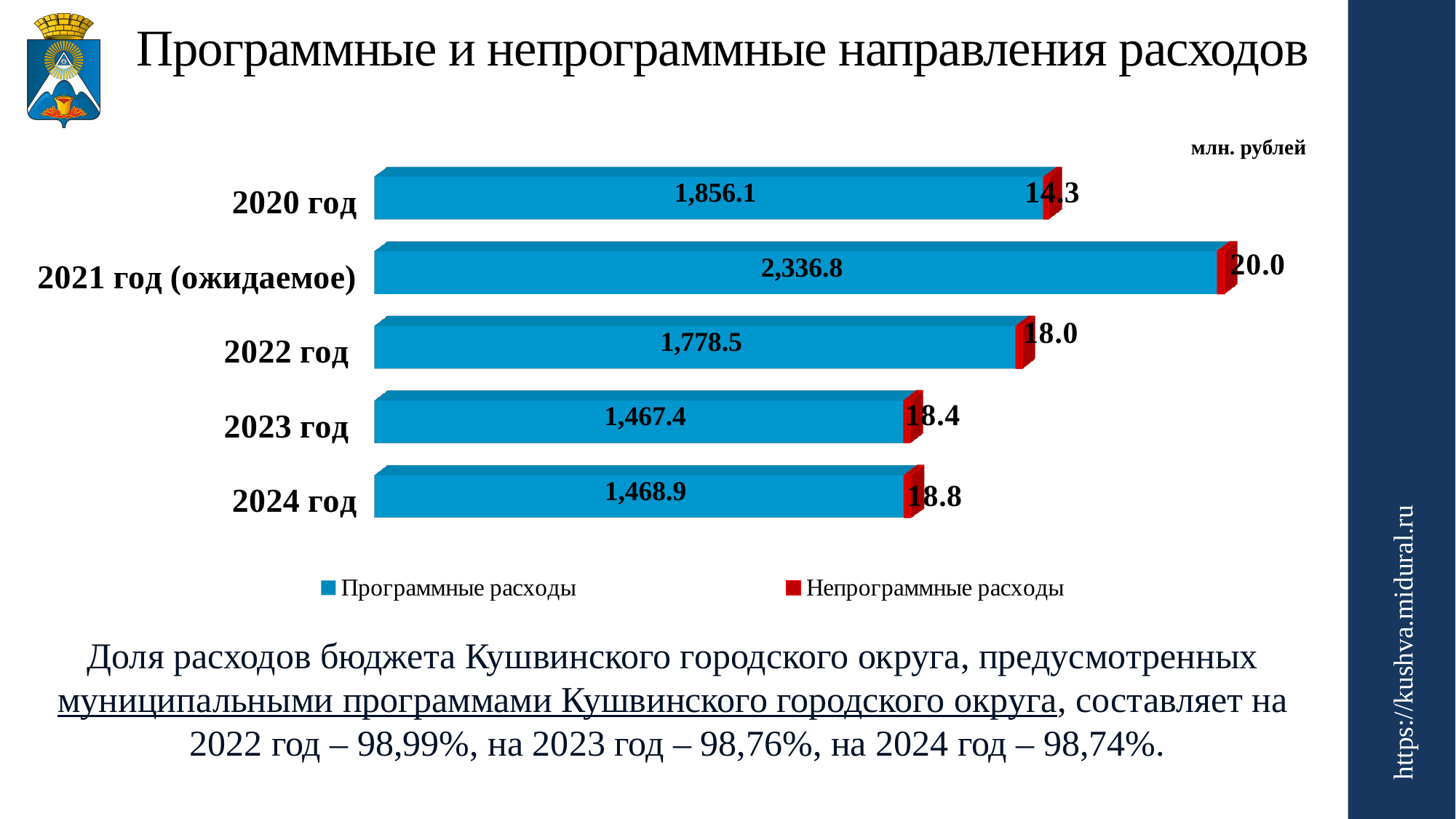
How many series does the legend list? 2 What is the difference between Программные расходы in 2021 год (ожидаемое) and in 2020 год? 480.7 Which is larger: Непрограммные расходы in 2023 год or in 2024 год? 2024 год What is the value of Непрограммные расходы for 2021 год (ожидаемое)? 20.0 Which year has the lowest value of Непрограммные расходы? 2020 год Do the values of Программные расходы rise or fall from 2021 год (ожидаемое) to 2023 год? Fall What kind of chart is shown on the slide? Stacked bar chart Which year has the highest value of Программные расходы? 2021 год (ожидаемое) What is the value of Программные расходы for 2024 год? 1,468.9 What is the total of the stacked bar for 2022 год? 1,796.5 How many years are shown on the chart? 5 What is the value of Программные расходы for 2020 год? 1,856.1